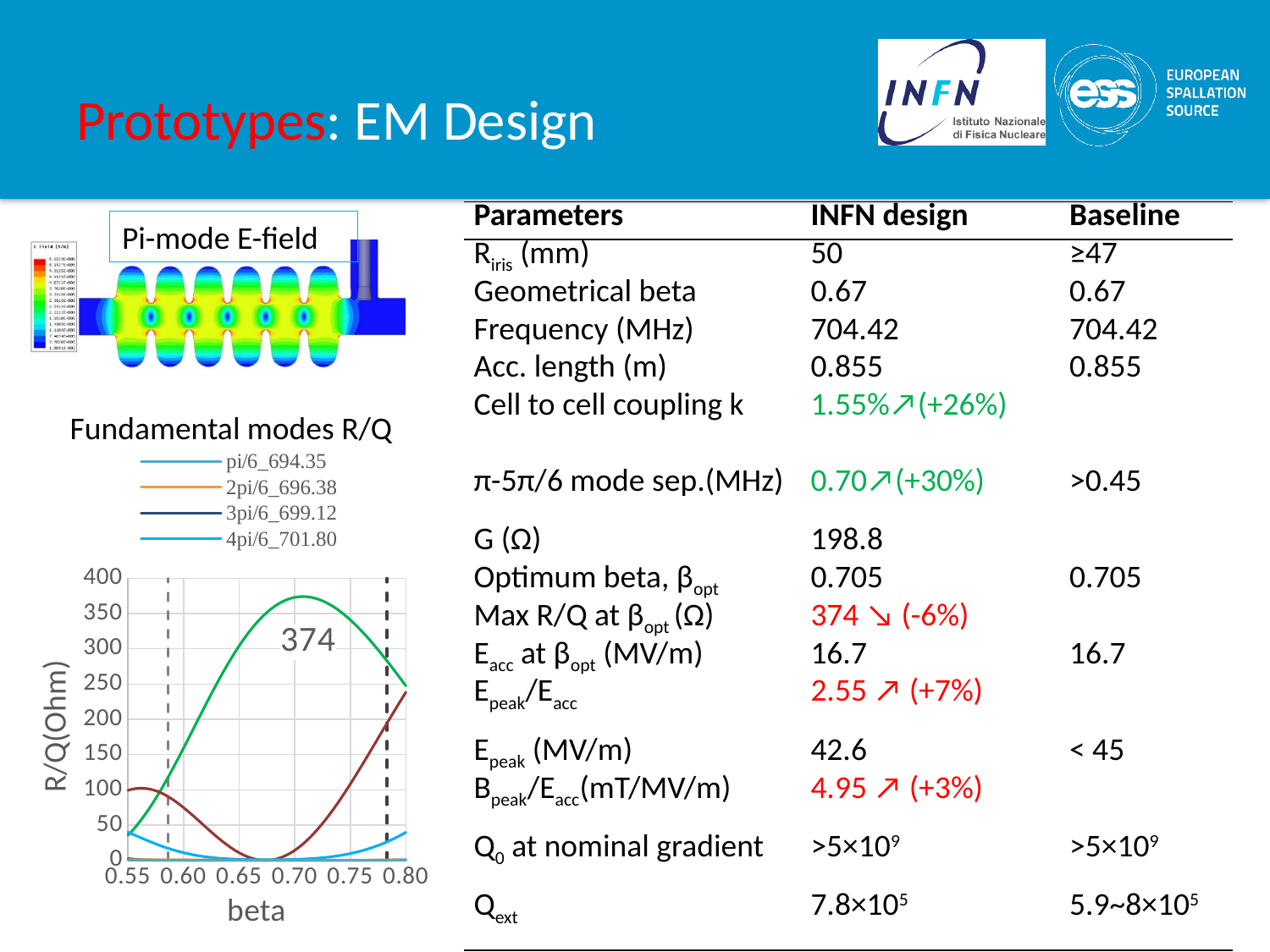
In the "Fundamental modes R/Q" chart, does the green curve rise or fall between beta 0.55 and beta 0.70? rise In the "Fundamental modes R/Q" chart, is the value of the green curve at beta 0.80 greater or less than 200? greater What type of chart is the "Fundamental modes R/Q" chart? line chart In the "Fundamental modes R/Q" chart, does the green curve rise or fall between beta 0.70 and beta 0.80? fall In the "Fundamental modes R/Q" chart, is the labelled peak value greater or less than 350? greater How many series does the legend of the "Fundamental modes R/Q" chart list? 4 What peak value is labelled on the "Fundamental modes R/Q" chart? 374 What is the label of the x axis of the "Fundamental modes R/Q" chart? beta In the "Fundamental modes R/Q" chart, is the value of the green curve at beta 0.55 greater or less than 100? less What is the title of the chart on the left of the slide? Fundamental modes R/Q What is the highest tick value shown on the y axis of the "Fundamental modes R/Q" chart? 400 What is the first legend entry of the "Fundamental modes R/Q" chart? pi/6_694.35